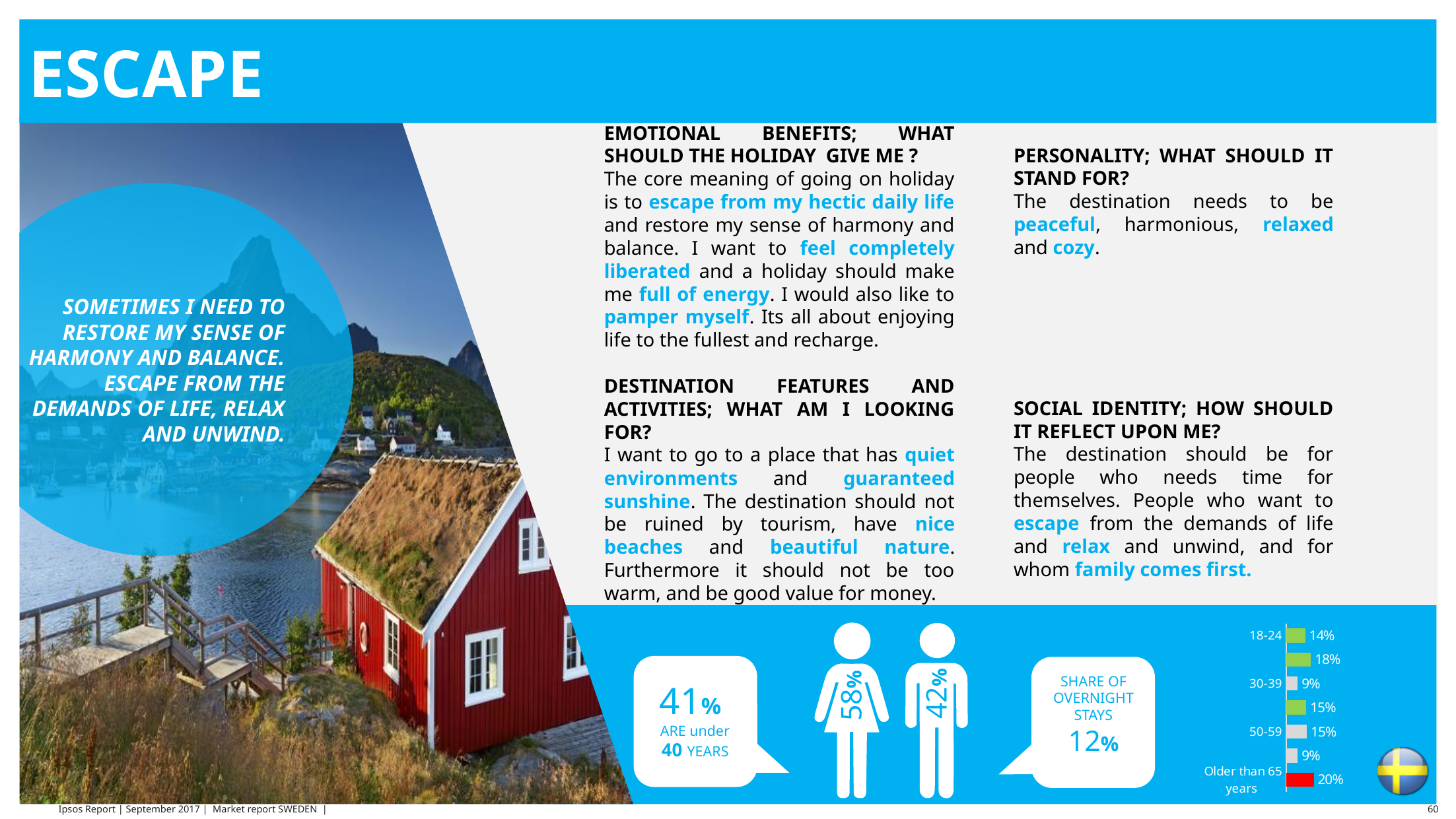
In the bar chart at the bottom right, what is the value for the 'Older than 65 years' group? 20% In the bar chart at the bottom right, what is the difference between the values for 50-59 and 30-39? 6% In the bar chart at the bottom right, which labelled age group has the lowest value? 30-39 In the bar chart at the bottom right, what is the value for the 30-39 age group? 9% In the bar chart at the bottom right, what is the difference between the values for 'Older than 65 years' and 18-24? 6% In the bar chart at the bottom right, which labelled age group has the highest value? Older than 65 years In the bar chart at the bottom right, what colour is the bar for 'Older than 65 years'? red What kind of chart is shown at the bottom right of the slide? bar chart In the bar chart at the bottom right, what is the value for the 50-59 age group? 15% In the bar chart at the bottom right, what is the value for the 18-24 age group? 14% How many bars are plotted in the bar chart at the bottom right? 7 In the bar chart at the bottom right, which is larger: the value for 18-24 or the value for 30-39? 18-24